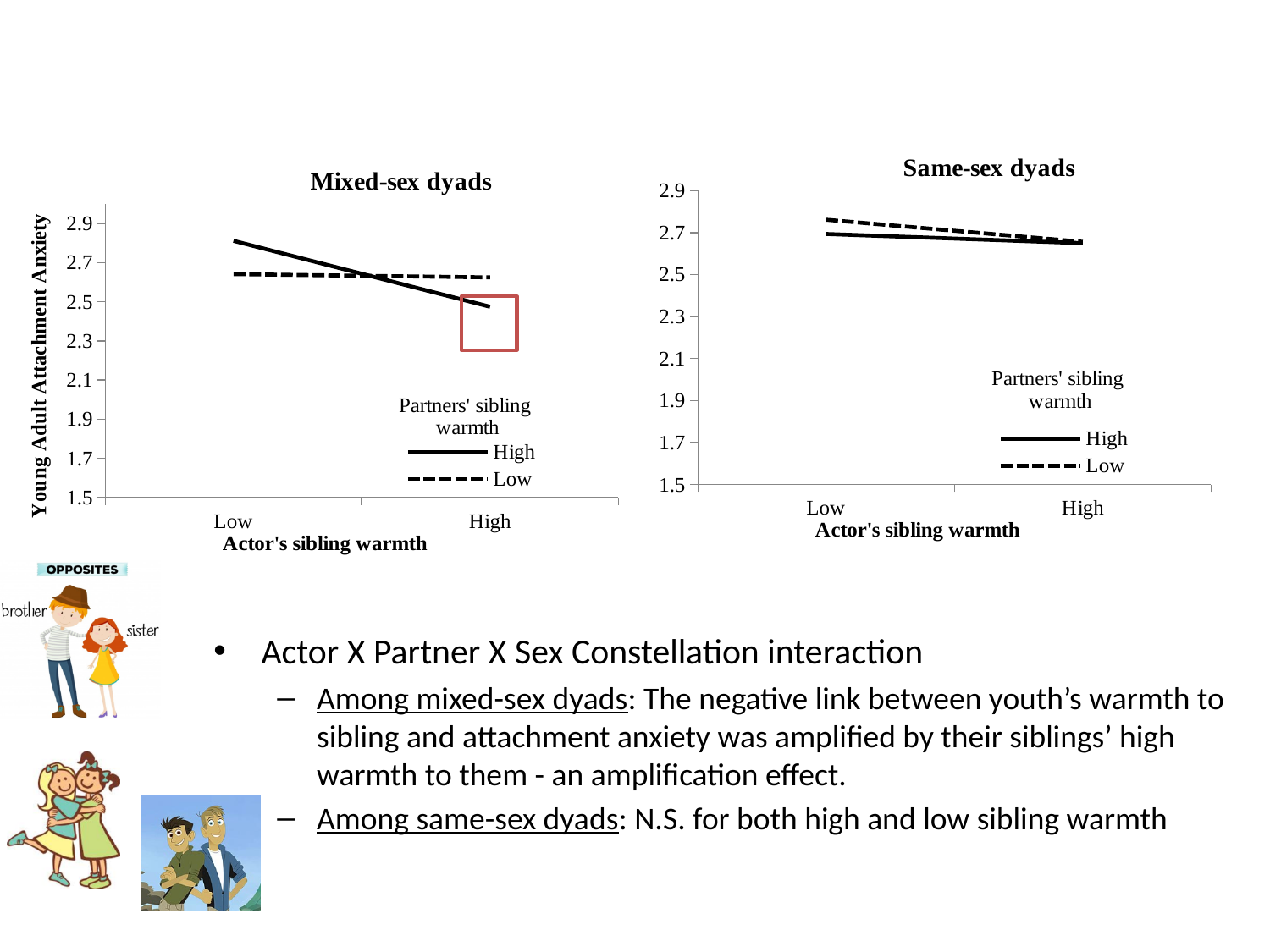
In the Mixed-sex dyads chart, does the High partners' sibling warmth line rise or fall from Low to High actor's sibling warmth? fall In the Mixed-sex dyads chart, is the value of the High partners' sibling warmth line at High actor's sibling warmth greater or less than 2.7? less In the Mixed-sex dyads chart, at High actor's sibling warmth, which line is higher: High or Low partners' sibling warmth? Low In the Mixed-sex dyads chart, is the value of the High partners' sibling warmth line at Low actor's sibling warmth greater or less than 2.7? greater What kind of chart is the Mixed-sex dyads chart? line chart How many categories are on the x axis of the Mixed-sex dyads chart? 2 In the Same-sex dyads chart, is the value of the High partners' sibling warmth line at Low actor's sibling warmth greater or less than 2.5? greater What is the title of the chart on the right of the slide? Same-sex dyads In the Same-sex dyads chart, does the Low partners' sibling warmth line rise or fall from Low to High actor's sibling warmth? fall How many series does the legend of the Same-sex dyads chart list? 2 In the Mixed-sex dyads chart, at Low actor's sibling warmth, which line is higher: High or Low partners' sibling warmth? High What is the y-axis label of the Mixed-sex dyads chart? Young Adult Attachment Anxiety